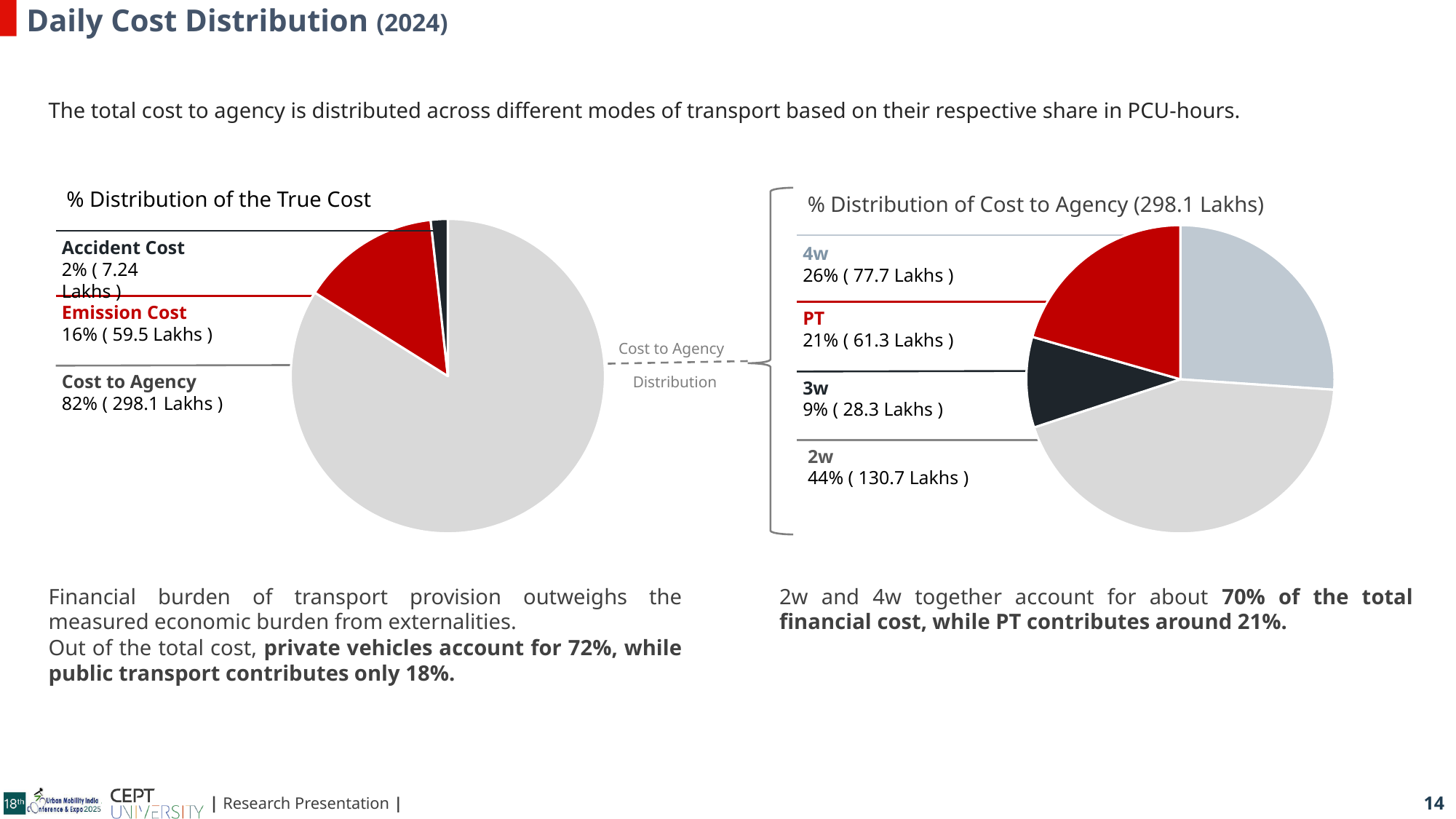
In the '% Distribution of Cost to Agency' pie chart, how many categories are shown? 4 In the '% Distribution of Cost to Agency' pie chart, what is the difference in percentage points between the 2w share and the 3w share? 35 percentage points What kind of chart is the '% Distribution of the True Cost' chart? Pie chart In the '% Distribution of Cost to Agency' pie chart, what share does 2w have? 44% In the '% Distribution of Cost to Agency' pie chart, which category has the largest share? 2w In the '% Distribution of the True Cost' pie chart, what share does Cost to Agency have? 82% In the '% Distribution of the True Cost' pie chart, what is the value for Emission Cost in Lakhs? 59.5 Lakhs In the '% Distribution of the True Cost' pie chart, which category has the smallest share? Accident Cost In the '% Distribution of Cost to Agency' pie chart, which is larger, the share for 4w or the share for PT? 4w In the '% Distribution of the True Cost' pie chart, how many slices are there? 3 In the '% Distribution of Cost to Agency' pie chart, what is the value for PT in Lakhs? 61.3 Lakhs In the '% Distribution of Cost to Agency' pie chart, which category has the smallest share? 3w